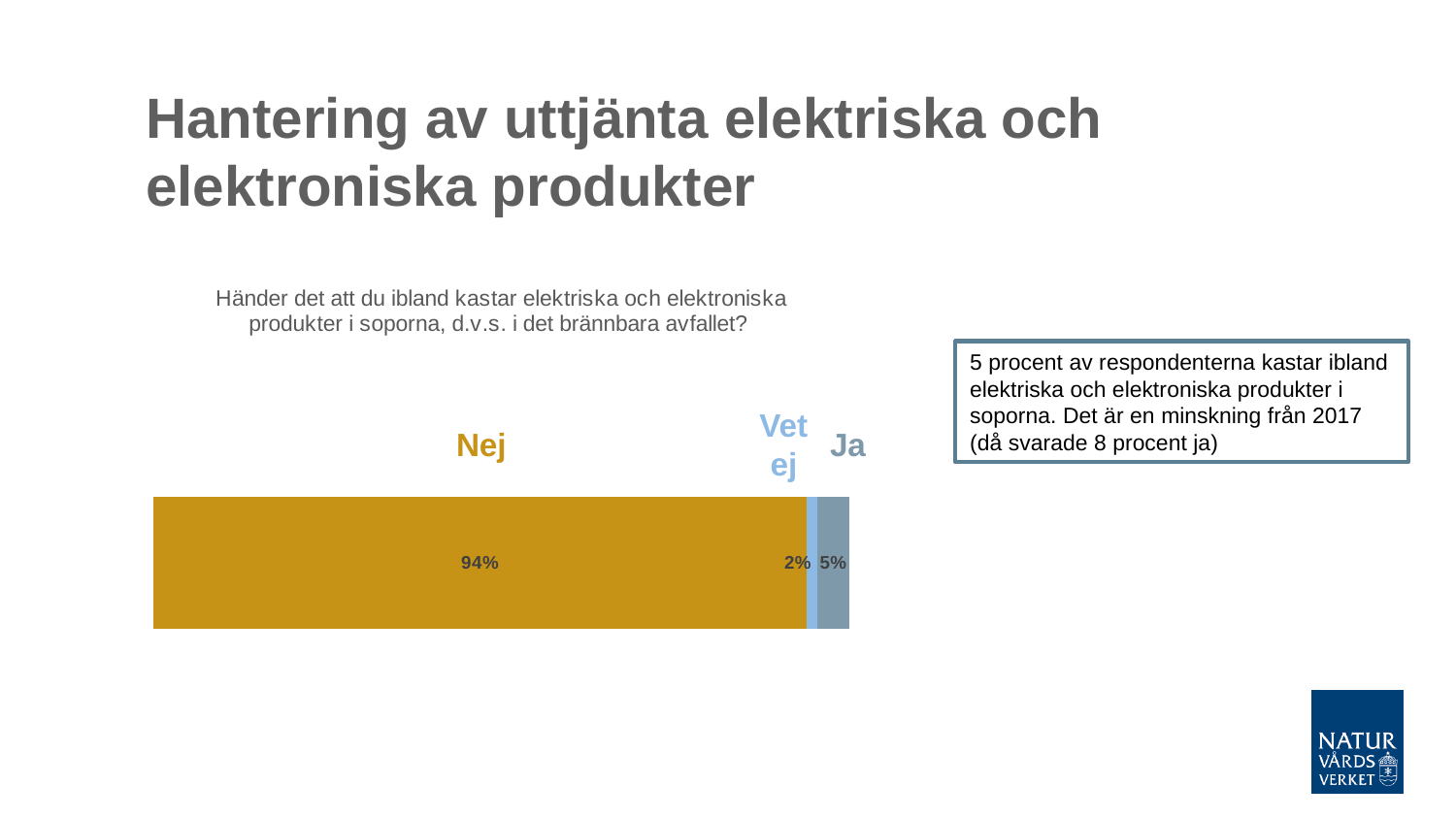
Which response category has the highest share? Nej How many response categories are shown in the bar? 3 What percentage of respondents answered "Ja"? 5% What colour is the "Nej" segment of the bar? Gold/yellow What is the difference in percentage points between "Ja" and "Vet ej"? 3 What kind of chart is shown on the slide? Stacked bar chart What is the difference in percentage points between "Nej" and "Ja"? 89 Which response category has the lowest share? Vet ej What percentage of respondents answered "Nej"? 94% Which is larger, the share for "Ja" or the share for "Vet ej"? Ja What is the total of the three segments in the stacked bar? 101% What percentage of respondents answered "Vet ej"? 2%